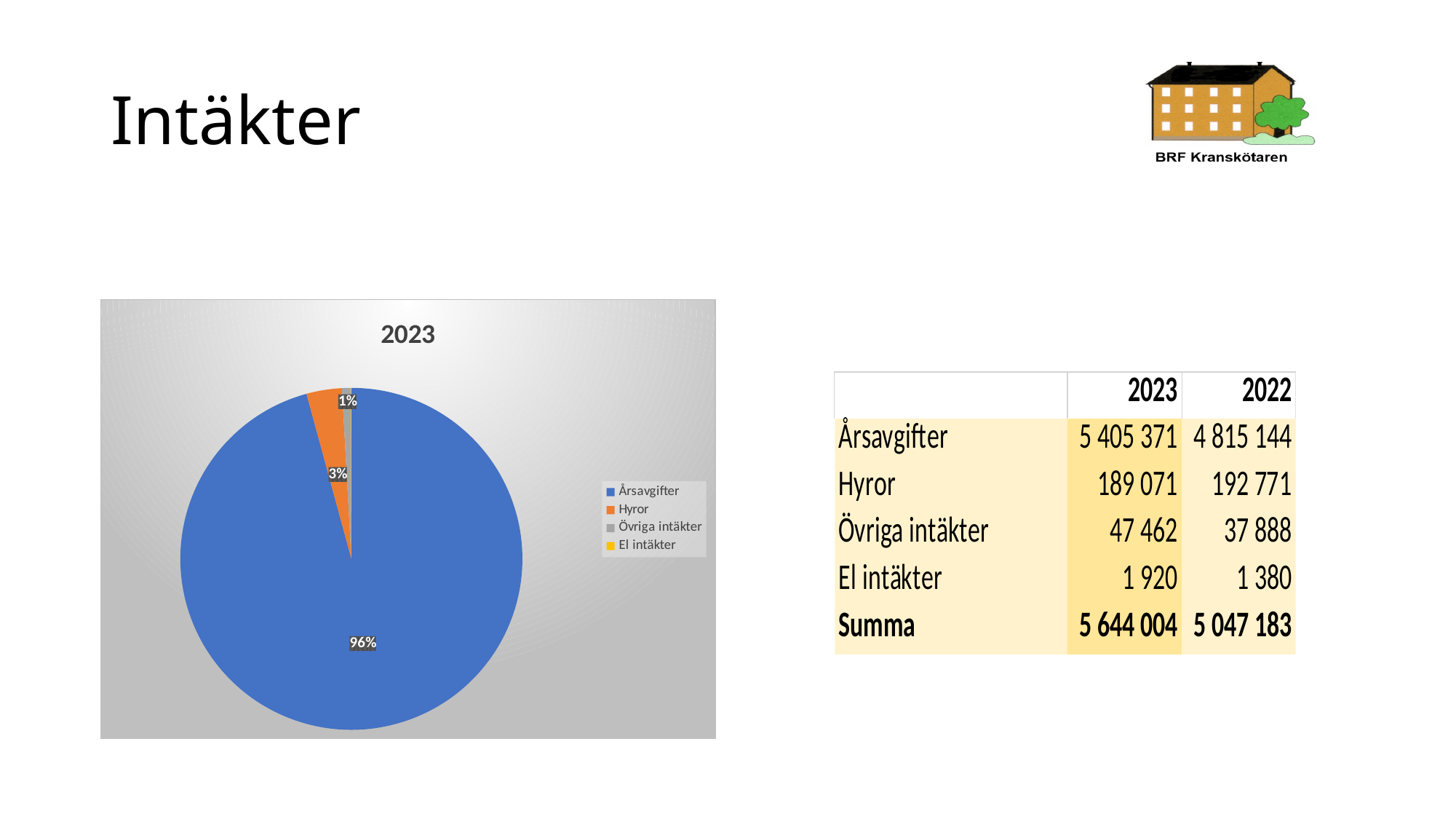
What share of the pie does Årsavgifter have? 96% Which colour represents Årsavgifter in the pie chart? blue How many entries does the legend of the pie chart list? 4 What kind of chart is shown on the slide? pie chart What is the difference in percentage points between the Årsavgifter slice and the Hyror slice? 93 Which category has the largest slice of the pie? Årsavgifter What share of the pie does Övriga intäkter have? 1% Which is larger in the pie chart, Hyror or Övriga intäkter? Hyror What is the title of the pie chart? 2023 What share of the pie does Hyror have? 3% Which legend entry is listed last in the pie chart's legend? El intäkter